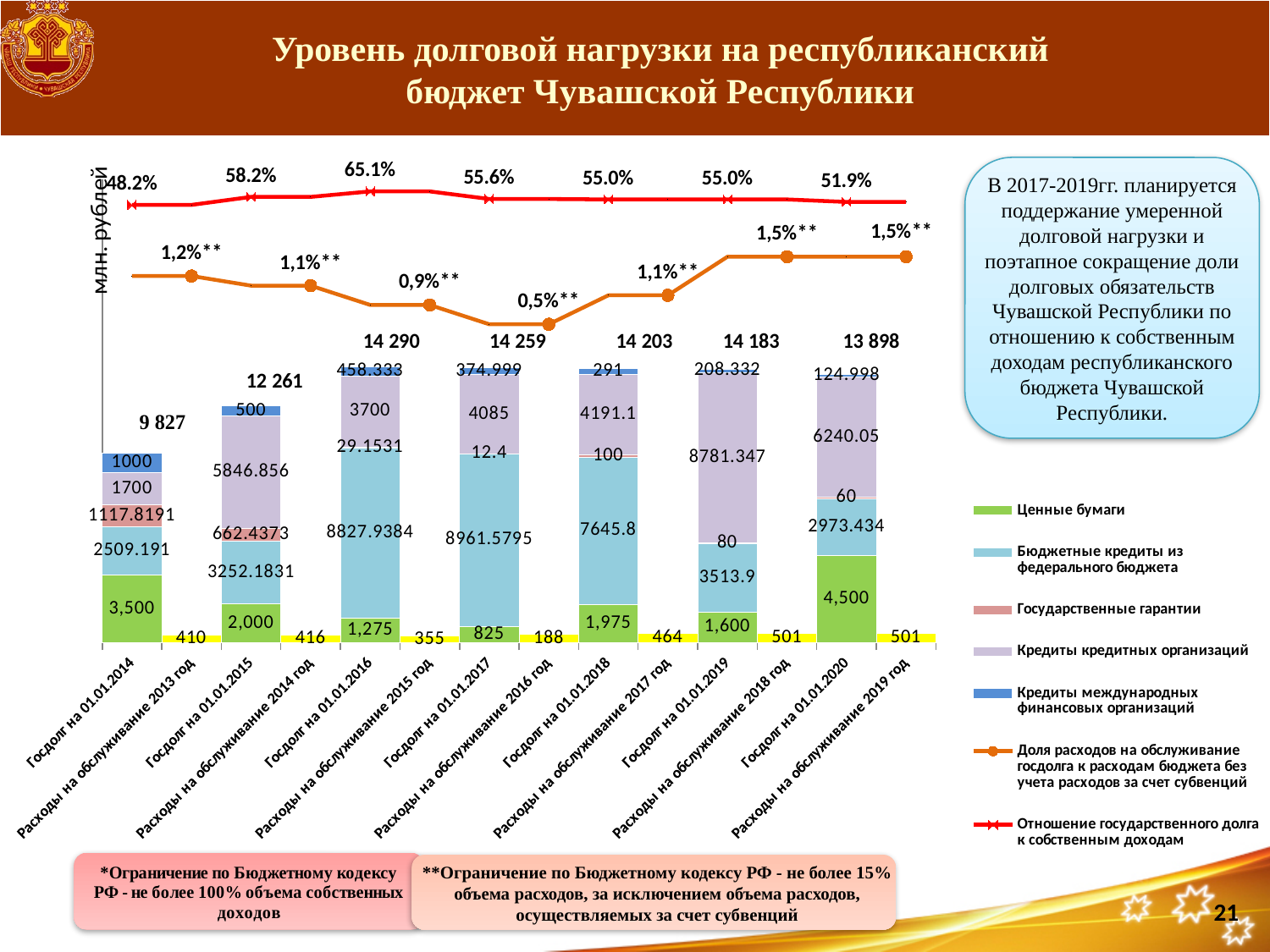
How many entries does the legend list? 7 What is the value shown for Расходы на обслуживание 2016 год? 188 What kind of chart is shown on the slide? stacked bar chart with line series At which date does the red line (Отношение государственного долга к собственным доходам) reach its highest value? Госдолг на 01.01.2016 (65.1%) What is the value of Ценные бумаги (green segment) for Госдолг на 01.01.2020? 4,500 Does the red line (Отношение государственного долга к собственным доходам) rise or fall from 01.01.2016 to 01.01.2020? fall What is the value of Бюджетные кредиты из федерального бюджета for Госдолг на 01.01.2017? 8961.5795 What is the total state debt (Госдолг) shown above the bar for 01.01.2016? 14 290 What is the difference between the total debt for 01.01.2016 (14 290) and for 01.01.2014 (9 827)? 4 463 What is the lowest value of the orange line (Доля расходов на обслуживание госдолга)? 0,5% Which is larger: Ценные бумаги for Госдолг на 01.01.2014 or for Госдолг на 01.01.2015? Госдолг на 01.01.2014 (3,500) What is the value of the red line (Отношение государственного долга к собственным доходам) for Госдолг на 01.01.2014? 48.2%